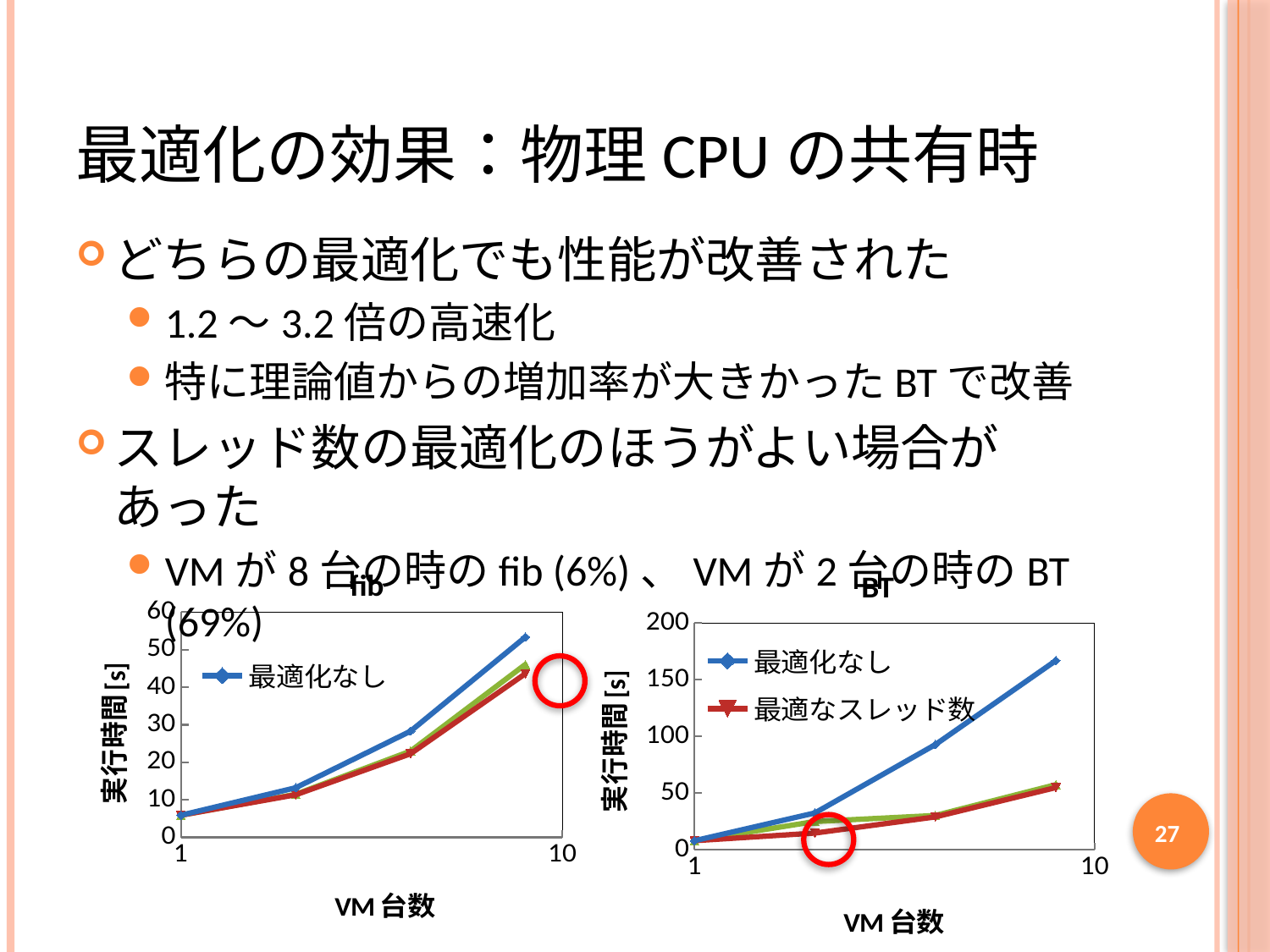
In the "BT" chart, does the 最適化なし line rise or fall as VM 台数 increases? rise In the "fib" chart, is the value of 最適化なし at VM 台数 = 1 greater or less than 10? less What kind of chart is the "BT" chart on the right? line chart In the "BT" chart, is the value of 最適なスレッド数 at the rightmost point greater or less than 100? less In the "BT" chart, at the rightmost point, which series has the larger value: 最適化なし or 最適なスレッド数? 最適化なし What is the x-axis title of the "BT" chart? VM 台数 In the "BT" chart, is the value of 最適化なし at the rightmost point greater or less than 150? greater In the "BT" chart, how many series does the legend list? 2 In the "fib" chart, how many series does the legend list? 1 What kind of chart is the "fib" chart on the left? line chart What is the y-axis title of the "fib" chart? 実行時間 [s]